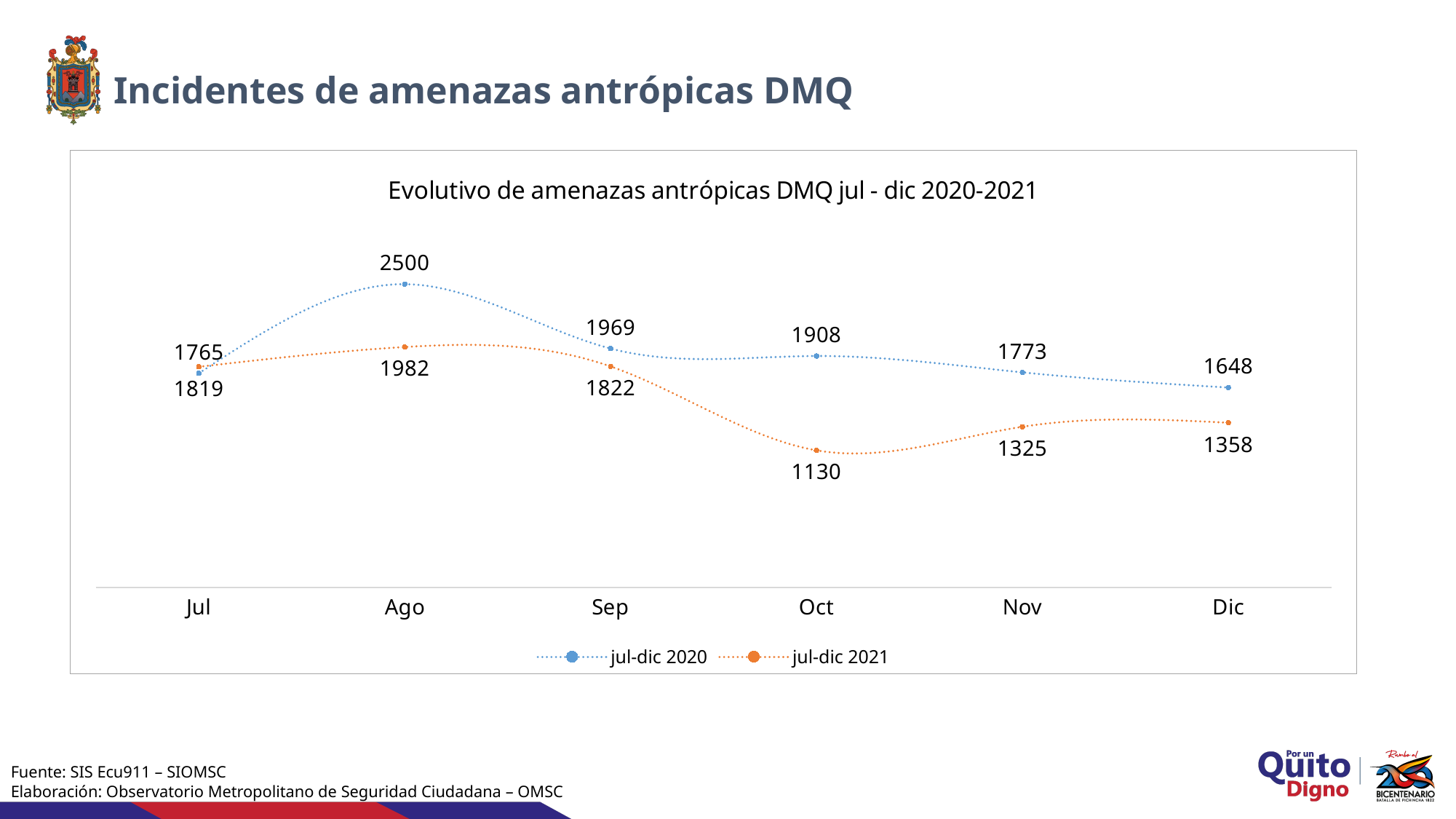
What kind of chart is shown? line chart Which series has the larger value in Jul, jul-dic 2020 or jul-dic 2021? jul-dic 2021 What is the value for jul-dic 2020 in Dic? 1648 What is the value for jul-dic 2021 in Nov? 1325 How many series does the legend list? 2 What is the difference between jul-dic 2020 and jul-dic 2021 in Oct? 778 How many months are shown on the x axis? 6 In which month is the jul-dic 2021 series lowest? Oct In which month is the jul-dic 2020 series highest? Ago What is the value for jul-dic 2020 in Ago? 2500 Does the jul-dic 2020 series rise or fall from Ago to Dic? fall What is the value for jul-dic 2021 in Oct? 1130